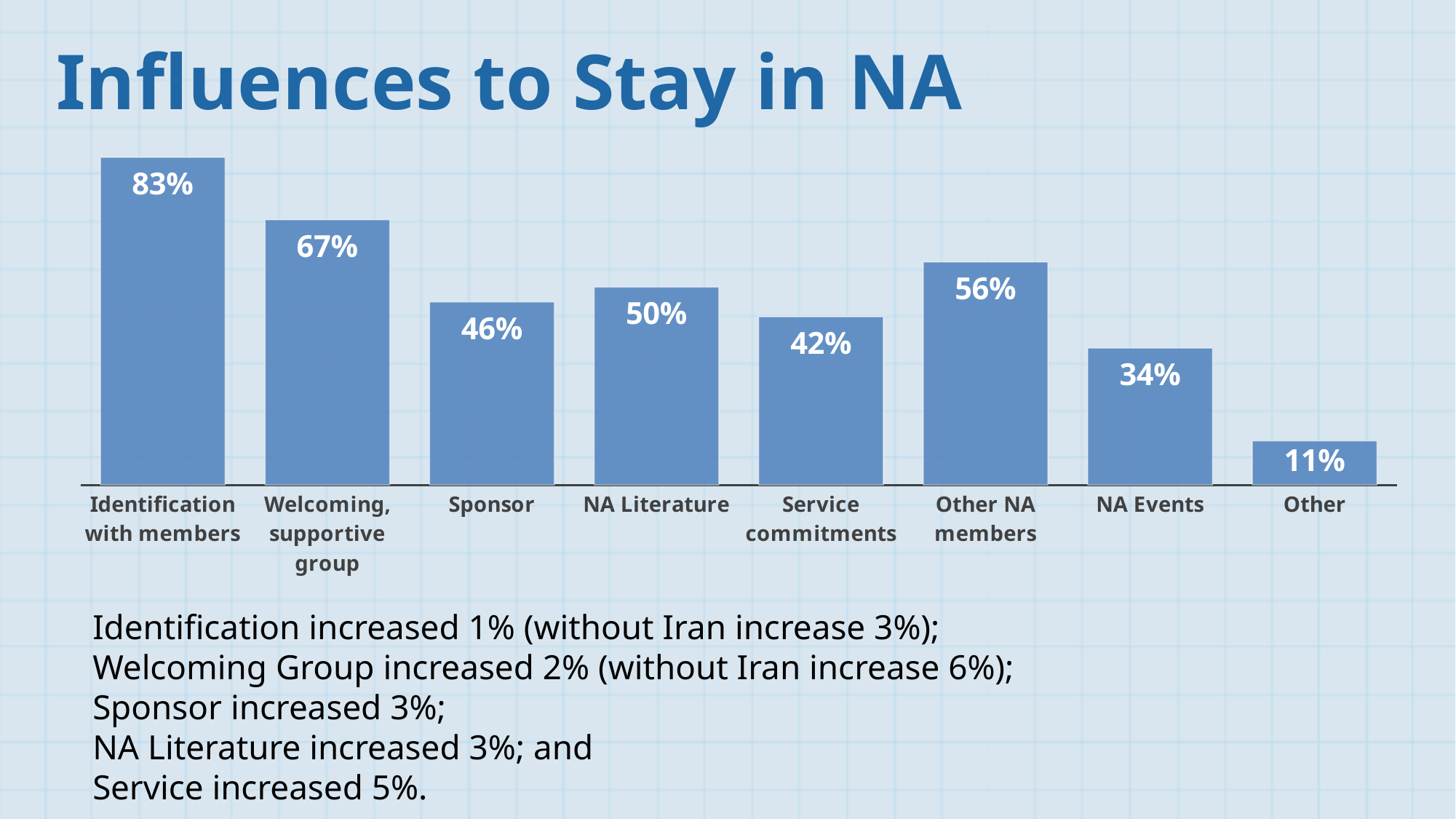
What is the difference between Welcoming, supportive group and Sponsor? 21% What is the value for Other NA members? 56% What is the value for NA Literature? 50% What is the title of the chart? Influences to Stay in NA What kind of chart is shown on the slide? Bar chart How many categories are shown in the chart? 8 Which category has the highest value? Identification with members Which is larger, Sponsor or Service commitments? Sponsor What is the difference between Other NA members and NA Events? 22% What percentage is shown for NA Events? 34% What percentage is shown for Identification with members? 83% Which category has the lowest value? Other